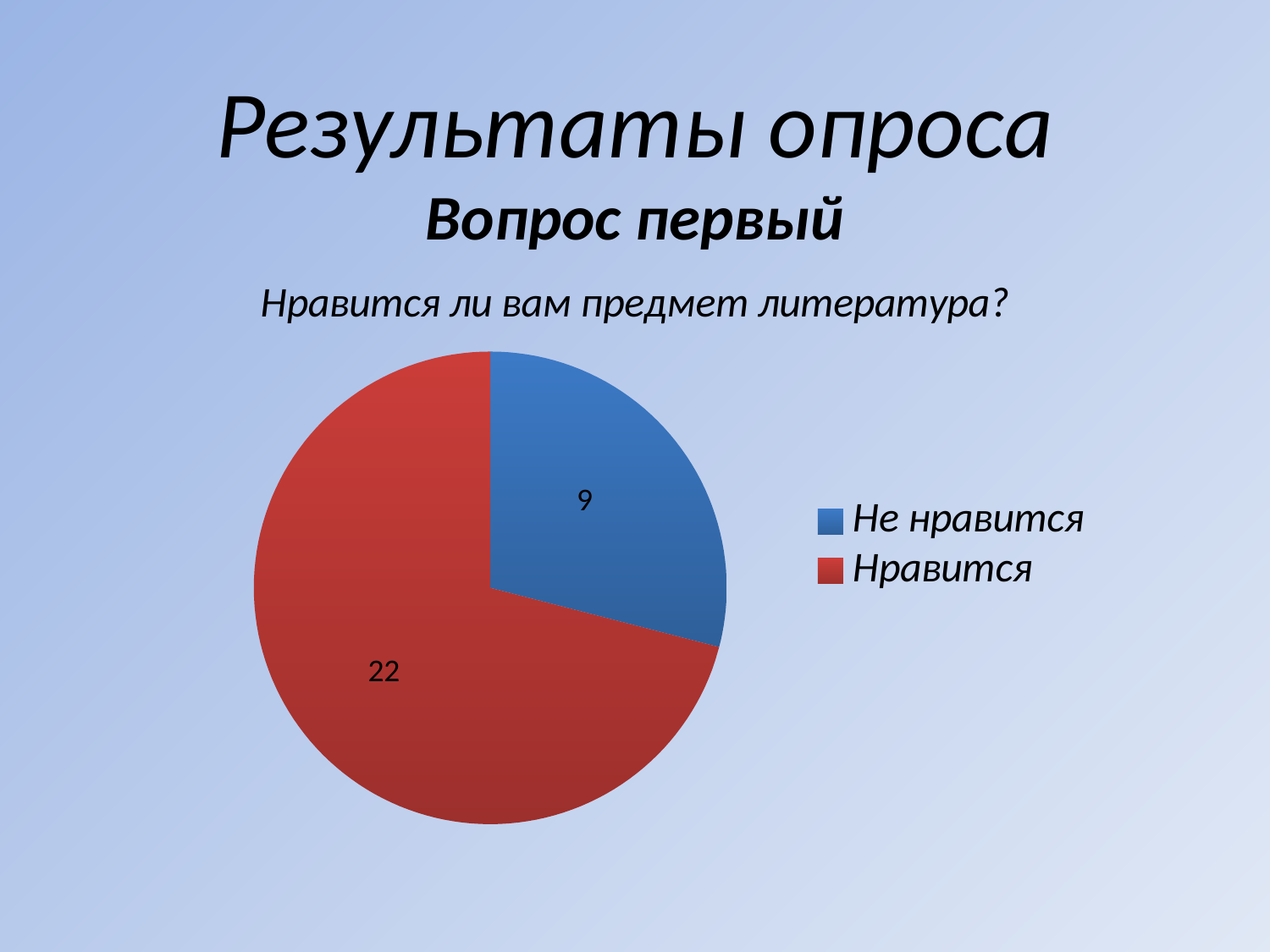
Which is larger: the "Нравится" slice or the "Не нравится" slice? Нравится How many people answered "Не нравится"? 9 Which answer has the smallest slice of the pie? Не нравится How many people answered "Нравится"? 22 What is the total number of responses shown in the pie chart? 31 How many slices does the pie chart have? 2 How many entries does the legend list? 2 What share of all responses does the "Нравится" slice represent? 22 out of 31 What colour is the "Не нравится" slice? blue Which answer has the largest slice of the pie? Нравится What type of chart is shown on the slide? pie chart What is the difference between the number of "Нравится" and "Не нравится" responses? 13